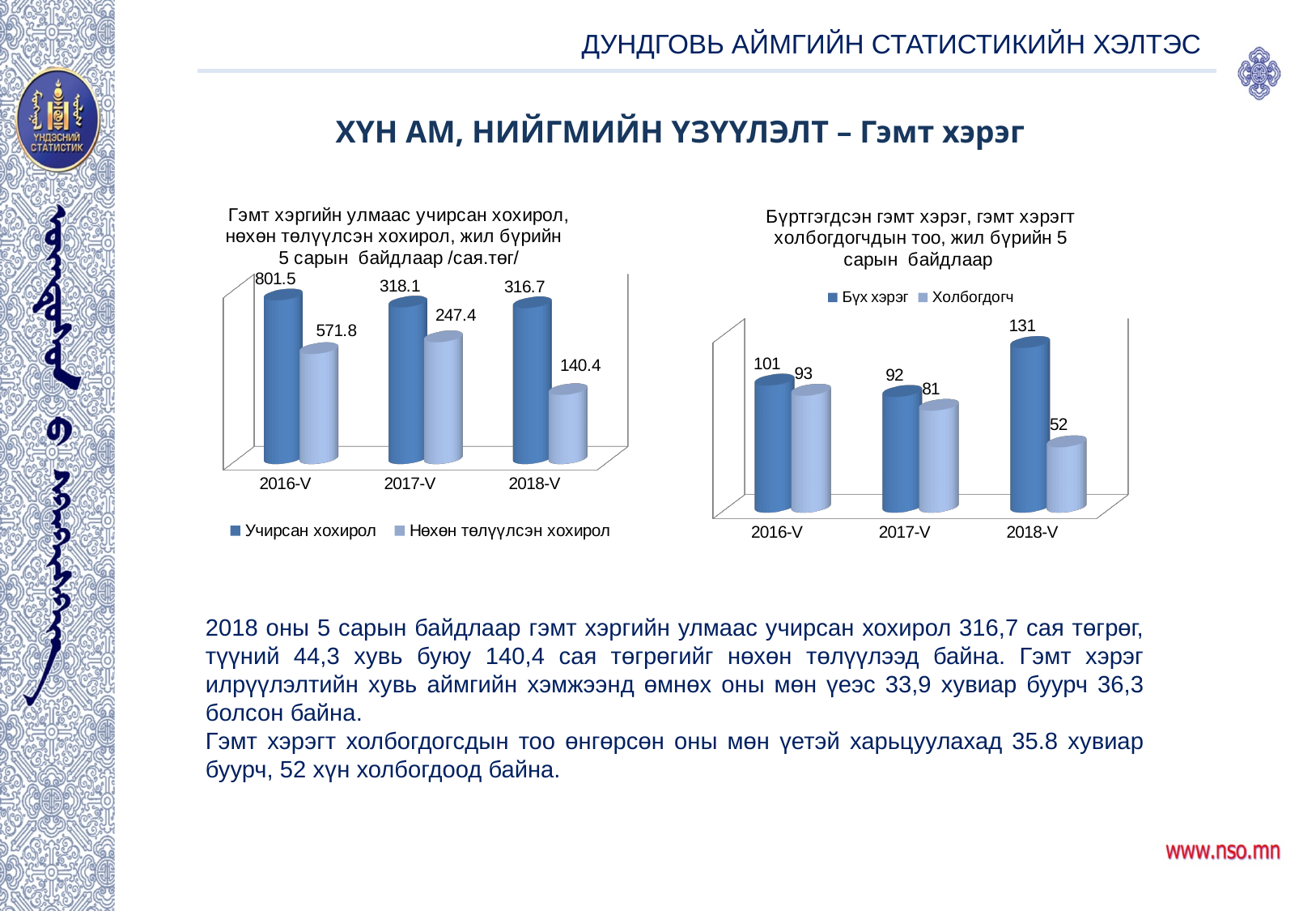
In the left chart (Гэмт хэргийн улмаас учирсан хохирол), which year has the lowest Нөхөн төлүүлсэн хохирол value? 2018-V In the left chart (Гэмт хэргийн улмаас учирсан хохирол), what is the value of Учирсан хохирол for 2018-V? 316.7 In the right chart (Бүртгэгдсэн гэмт хэрэг), which year has the lowest Холбогдогч value? 2018-V In the left chart (Гэмт хэргийн улмаас учирсан хохирол), what is the difference between Учирсан хохирол and Нөхөн төлүүлсэн хохирол for 2018-V? 176.3 In the right chart (Бүртгэгдсэн гэмт хэрэг), what is the value of Холбогдогч for 2017-V? 81 In the right chart (Бүртгэгдсэн гэмт хэрэг), what is the value of Бүх хэрэг for 2018-V? 131 In the right chart (Бүртгэгдсэн гэмт хэрэг), what is the difference between Бүх хэрэг and Холбогдогч for 2018-V? 79 In the left chart (Гэмт хэргийн улмаас учирсан хохирол), which year has the highest Учирсан хохирол value? 2016-V In the left chart (Гэмт хэргийн улмаас учирсан хохирол), how many series does the legend list? 2 In the left chart (Гэмт хэргийн улмаас учирсан хохирол), what is the value of Нөхөн төлүүлсэн хохирол for 2016-V? 571.8 What kind of chart is the right chart (Бүртгэгдсэн гэмт хэрэг)? bar chart In the left chart (Гэмт хэргийн улмаас учирсан хохирол), does the Нөхөн төлүүлсэн хохирол value rise or fall from 2016-V to 2018-V? fall